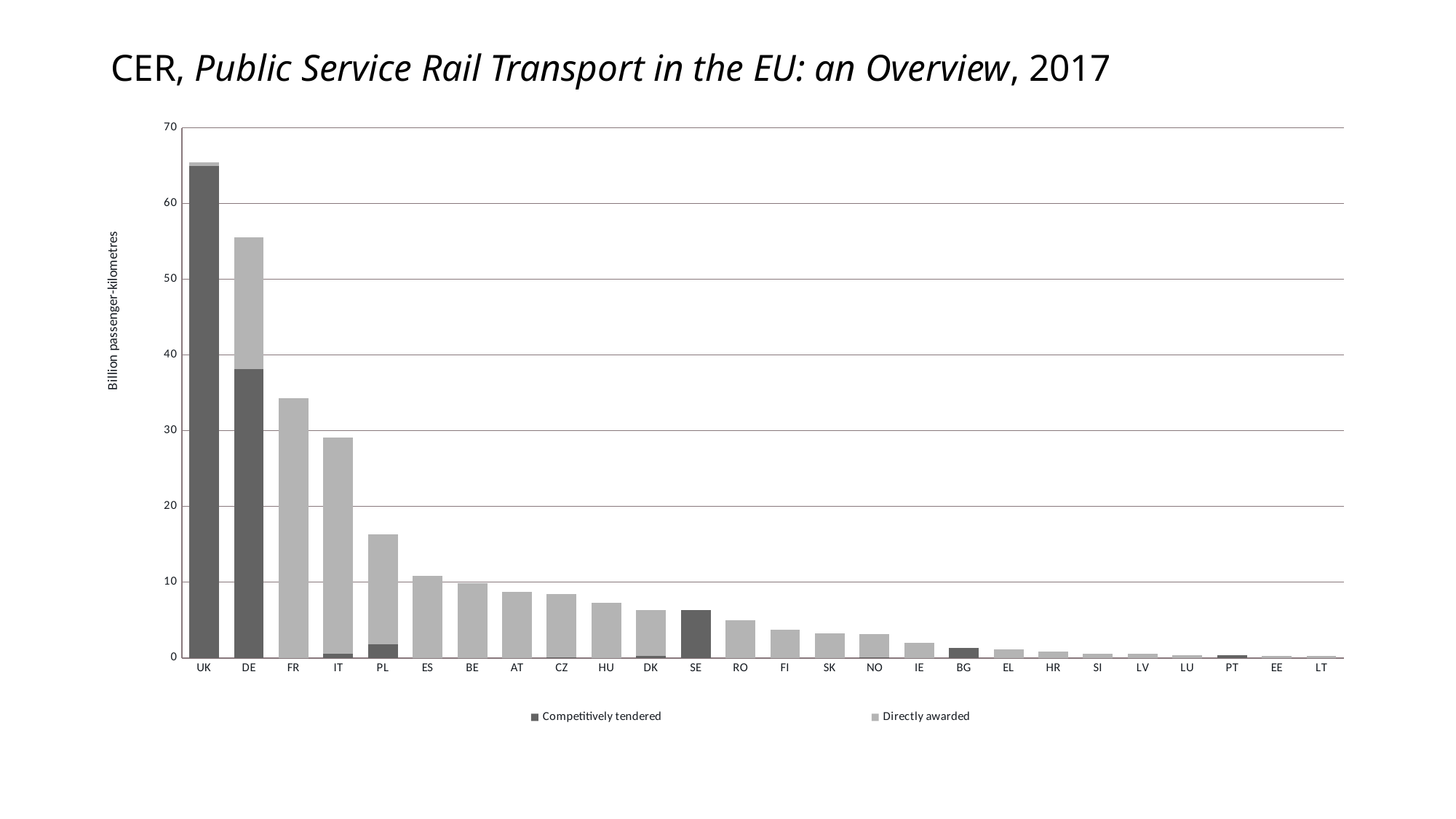
Is the total value for FR greater or less than 40? less Is the total value for PL greater or less than 20? less What is the label on the vertical axis? Billion passenger-kilometres How many countries are shown along the x axis? 26 Is the total value for DE greater or less than 50? greater Which legend entry is shown in the darker grey colour? Competitively tendered Which has the taller bar, FR or IT? FR What kind of chart is shown on the slide? Stacked bar chart Do the bar heights generally rise or fall from left to right along the x axis? Fall How many series does the legend list? 2 Which country has the tallest bar overall? UK